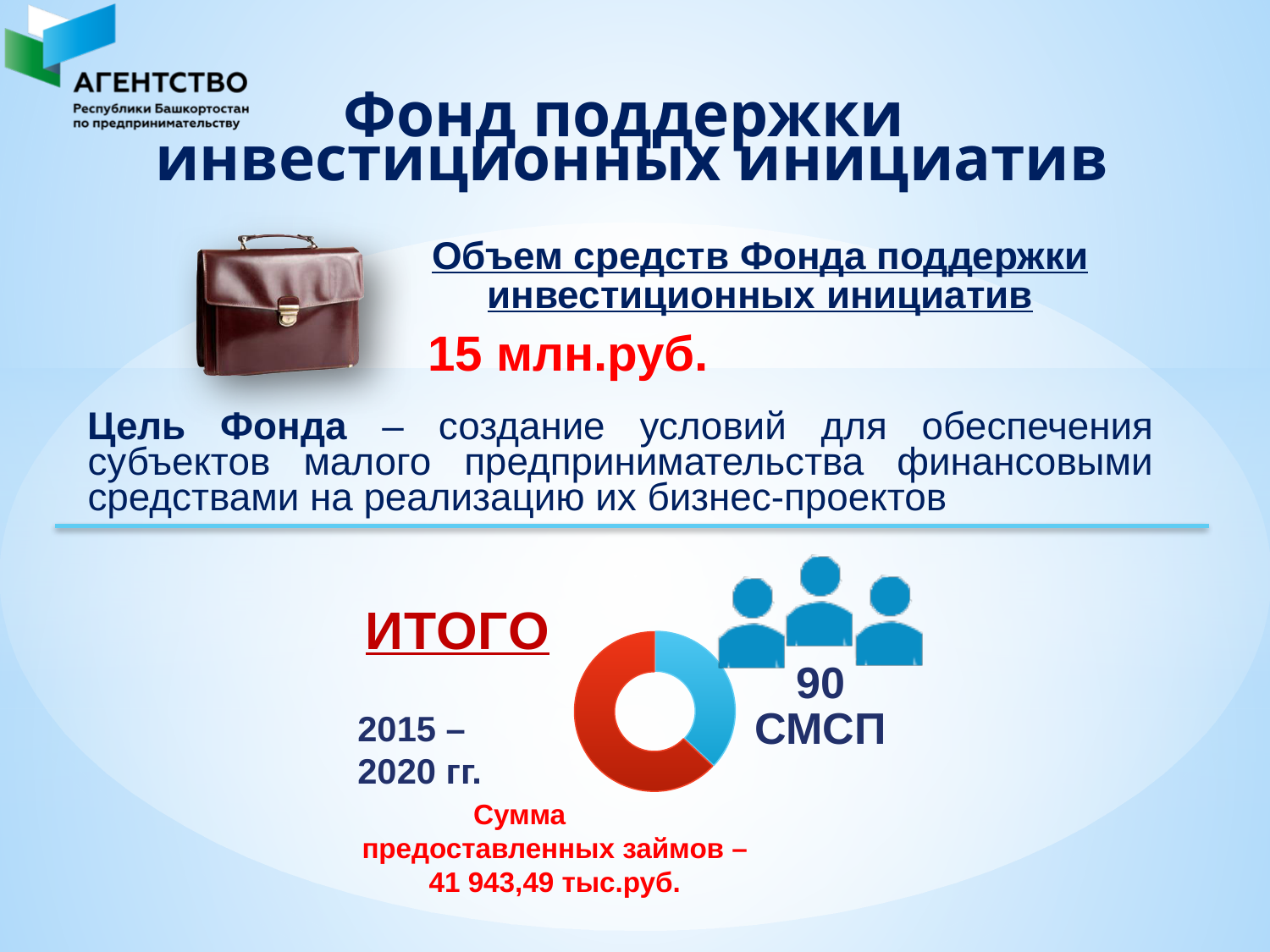
Does the blue slice of the doughnut chart cover more or less than half of the ring? less What total sum of loans (Сумма предоставленных займов) is printed below the doughnut chart? 41 943,49 тыс.руб. What two colours are used for the slices of the doughnut chart? red and blue How many СМСП are shown in the blue label next to the doughnut chart? 90 What kind of chart is shown at the bottom of the slide? doughnut (pie) chart Which colour slice takes up the smallest share of the doughnut chart? blue How many slices does the doughnut chart have? 2 Which slice of the doughnut chart is larger, the red one or the blue one? the red one Which colour slice takes up the largest share of the doughnut chart? red What period is labelled next to the doughnut chart under the heading ИТОГО? 2015 – 2020 гг.